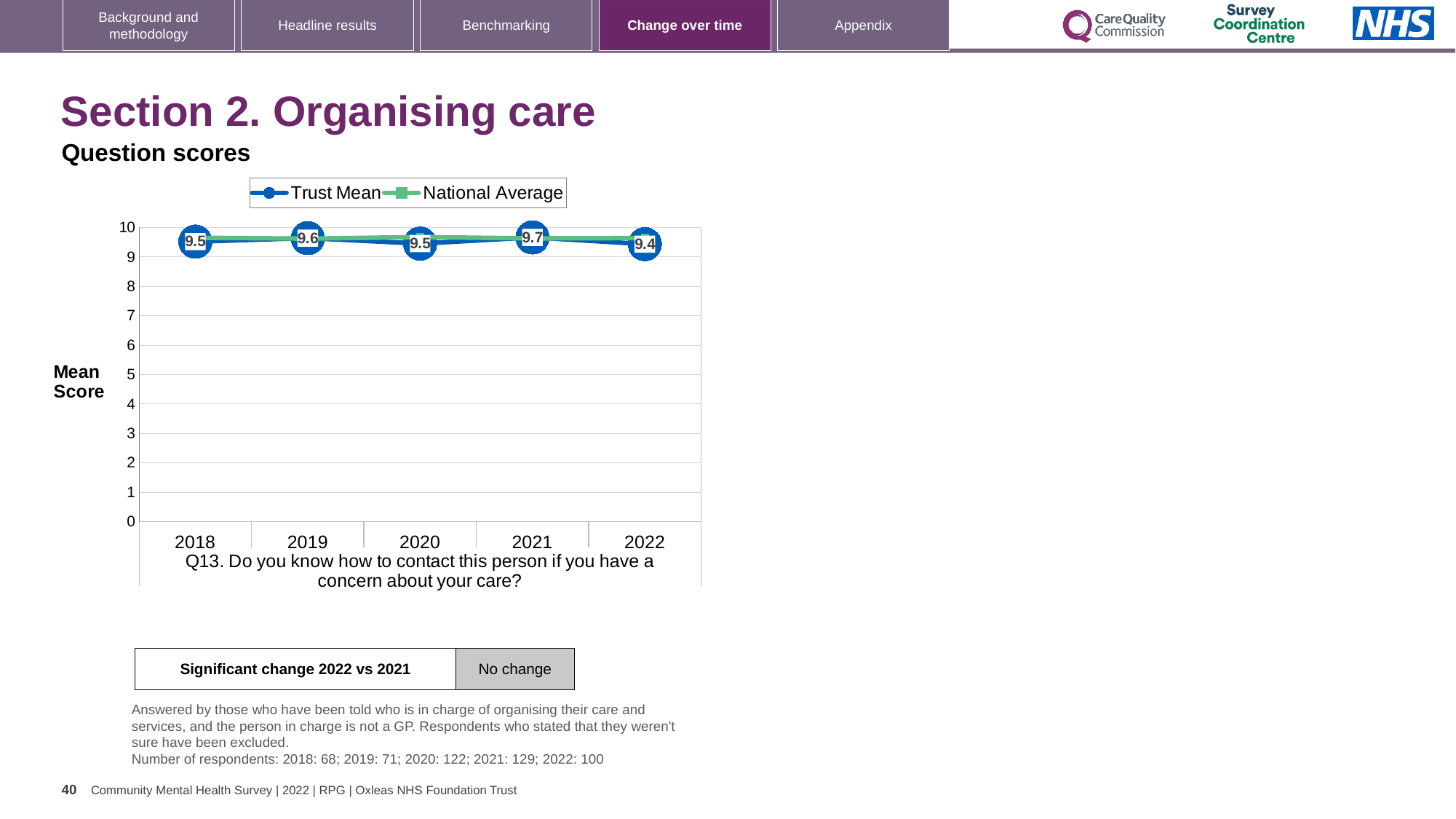
What kind of chart is shown on the slide? Line chart Is the Trust Mean score for 2020 greater or less than 9? greater How many years are shown on the x axis of the chart? 5 What is the Trust Mean score for 2021? 9.7 Which question does the chart show scores for? Q13. Do you know how to contact this person if you have a concern about your care? What is the Trust Mean score for 2022? 9.4 In which year is the Trust Mean score lowest? 2022 In which year is the Trust Mean score highest? 2021 What is the difference between the Trust Mean scores for 2021 and 2022? 0.3 Which year has the larger Trust Mean score, 2019 or 2022? 2019 What is the Trust Mean score for 2018? 9.5 How many series does the chart legend list? 2